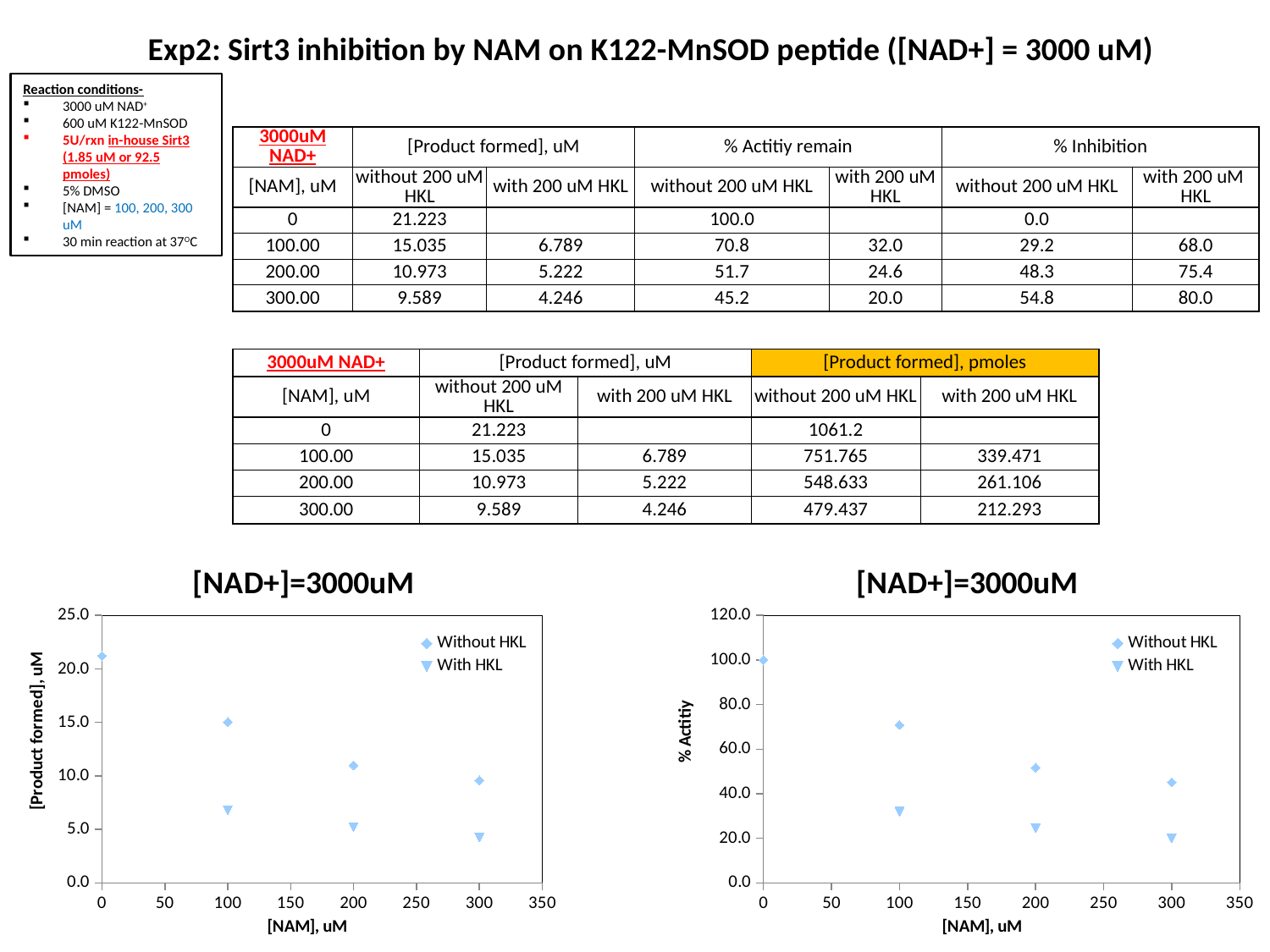
In the left chart, how many points are plotted for the Without HKL series? 4 In the left chart, at [NAM] = 200, which series has the larger value, Without HKL or With HKL? Without HKL In the right chart with the y-axis '% Actitiy', what is the Without HKL value at [NAM] = 0? 100.0 In the left chart, is the Without HKL value at [NAM] = 100 greater or less than 10.0? greater In the right chart, at which [NAM] value is the Without HKL series highest? 0 How many series does the legend of the left chart list? 2 What kind of chart is the left chart with the y-axis '[Product formed], uM'? scatter chart In the right chart, is the With HKL value at [NAM] = 200 greater or less than 40.0? less In the left chart, is the With HKL value at [NAM] = 300 greater or less than 5.0? less What is the x-axis label of the right chart? [NAM], uM In the left chart, do the Without HKL values rise or fall as [NAM] increases? fall In the left chart, how many points are plotted for the With HKL series? 3